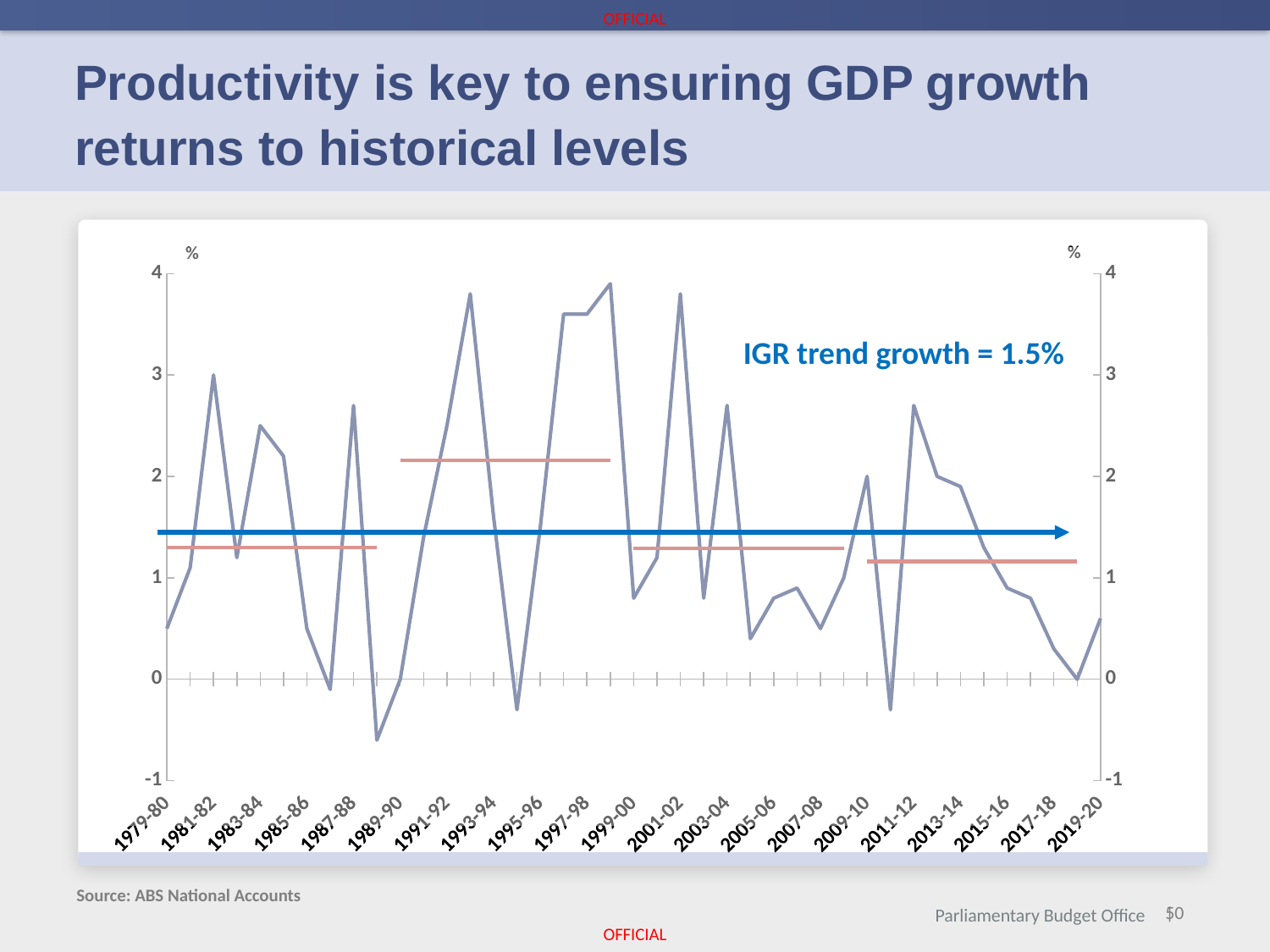
Is the value for 2017-18 greater or less than 1? less Is the value for 1993-94 greater or less than 3? less Is the value for 1997-98 greater or less than 3? greater What kind of chart is shown on the slide? line chart Which labelled year has the lowest value on the chart? 1989-90 What source is cited for the chart? ABS National Accounts What is the IGR trend growth rate annotated on the chart? 1.5% What is the highest value shown on the vertical axis? 4